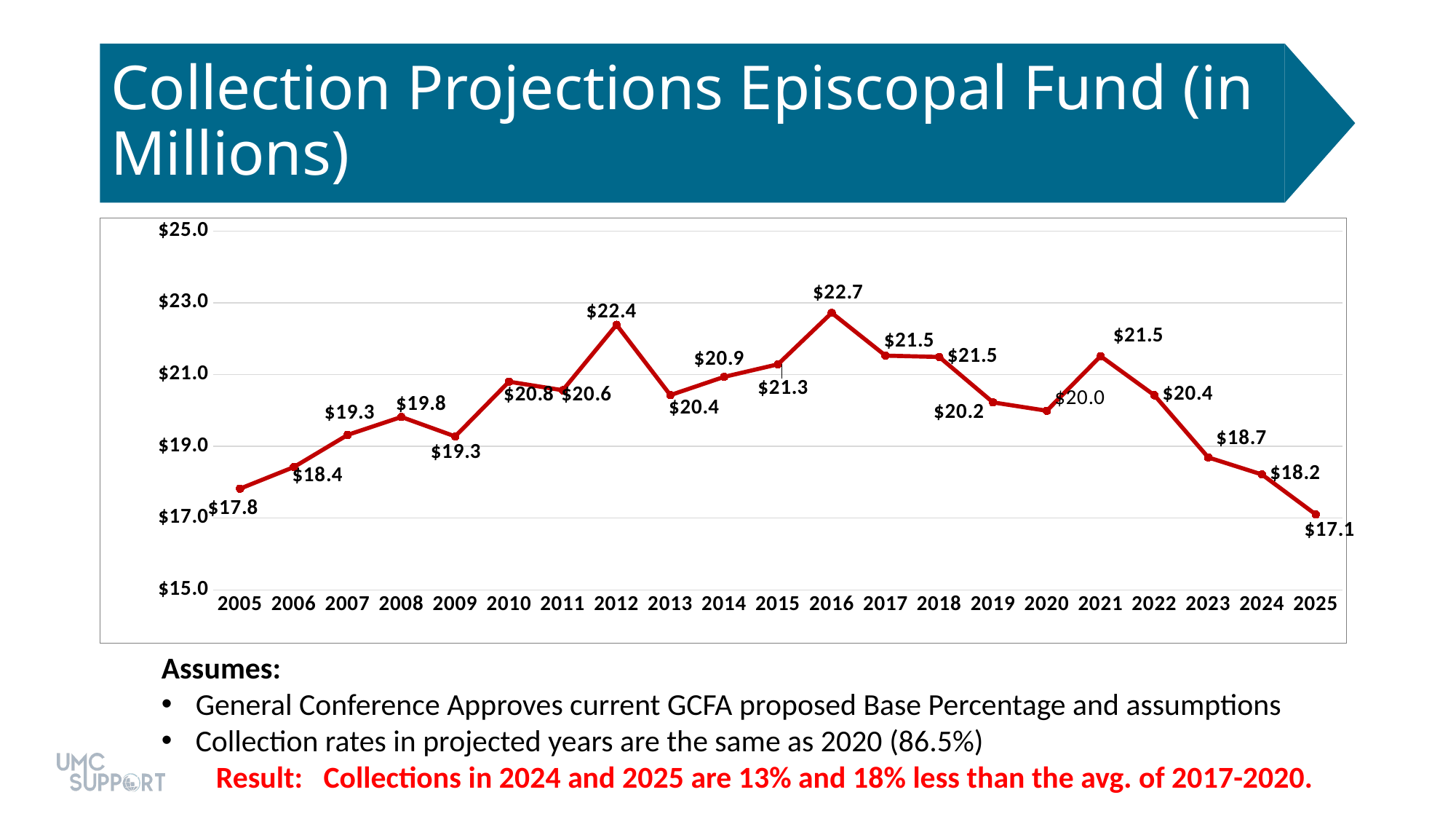
How many years are plotted on the chart? 21 What is the value for 2005? $17.8 What is the value for 2025? $17.1 Which year has the highest value? 2016 Which year has the lowest value? 2025 Is the value for 2021 greater or less than $21.0? greater Which is larger, the value for 2012 or the value for 2013? 2012 What is the value for 2012? $22.4 Do the values rise or fall from 2021 to 2025? Fall What is the difference between the values for 2016 and 2025? $5.6 What kind of chart is shown on the slide? Line chart What is the value for 2016? $22.7